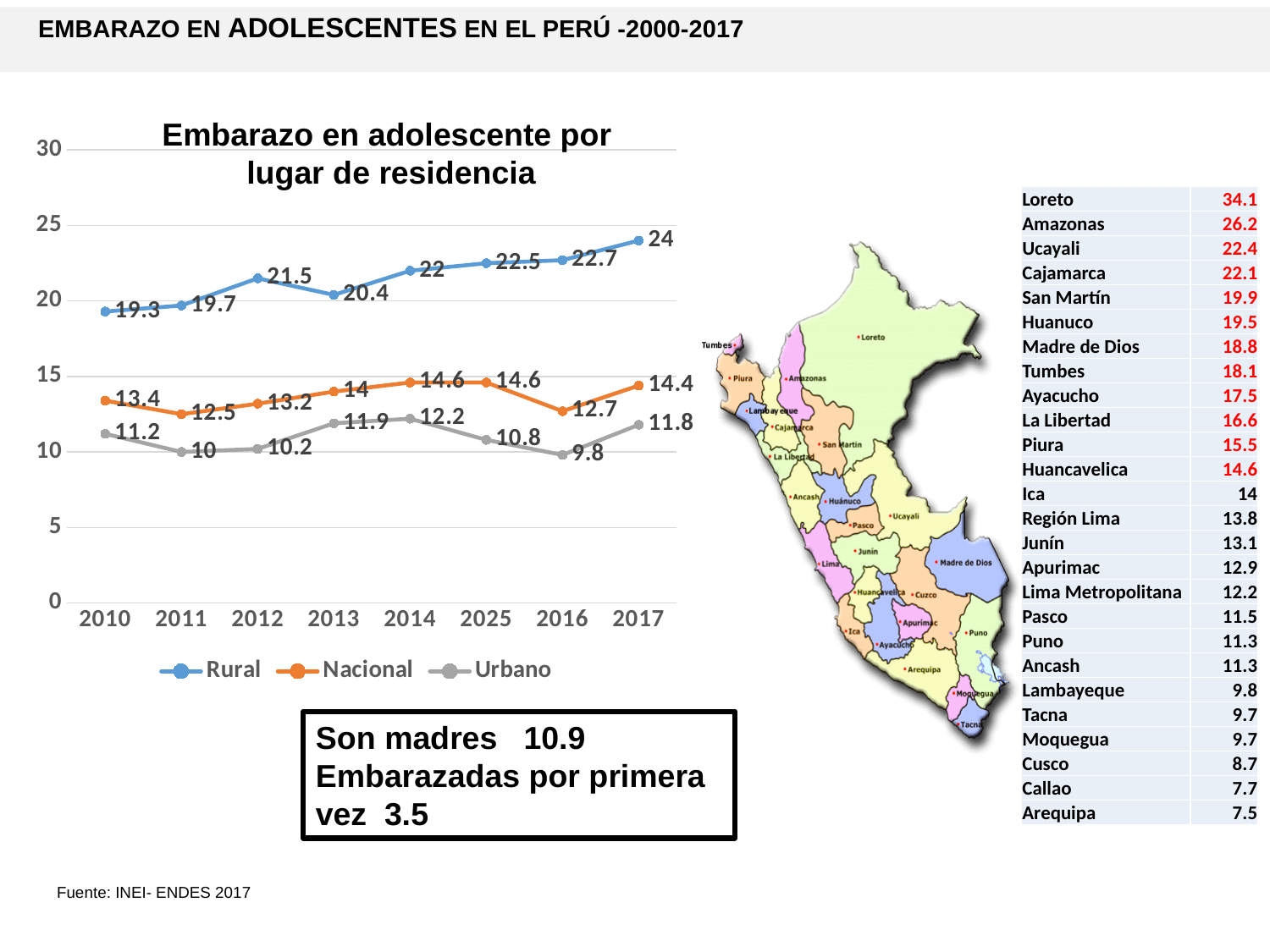
Does the Rural series generally rise or fall from 2010 to 2017? rise How many series does the legend of the chart list? 3 What is the Urbano value for 2016? 9.8 Which series is drawn in orange in the chart? Nacional In which year is the Rural series at its highest? 2017 Which is larger in 2013, the Nacional value or the Urbano value? Nacional In which year is the Urbano series at its lowest? 2016 What type of chart is "Embarazo en adolescente por lugar de residencia"? line chart What is the Rural value for 2017? 24 What is the Nacional value for 2010? 13.4 How many years are shown on the x axis of the chart? 8 What is the difference between the Rural and Urbano values in 2017? 12.2